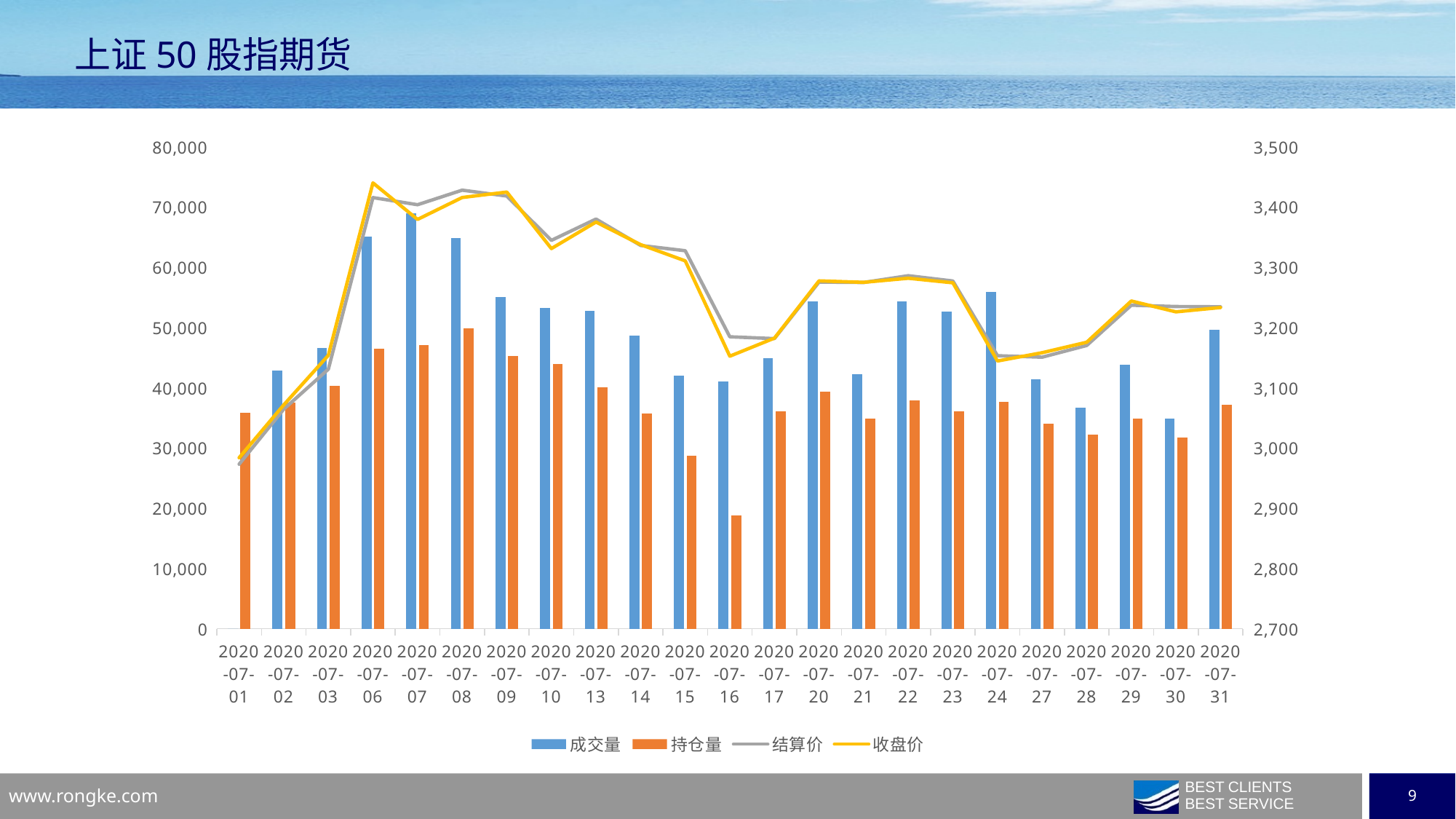
On which date is 成交量 highest? 2020-07-07 Does 收盘价 rise or fall from 2020-07-01 to 2020-07-06? rise On which date is 持仓量 lowest? 2020-07-16 Which colour represents 成交量 in the chart? Blue Which is larger, 成交量 on 2020-07-06 or 成交量 on 2020-07-24? 2020-07-06 How many series does the chart legend list? 4 How many dates are shown on the x axis of the chart? 23 Is the value of 成交量 on 2020-07-07 greater or less than 60,000? greater Is the value of 持仓量 on 2020-07-16 greater or less than 30,000? less On which date is 收盘价 highest? 2020-07-06 What kind of chart is shown on the slide? Combined bar and line chart On which date is 持仓量 highest? 2020-07-08